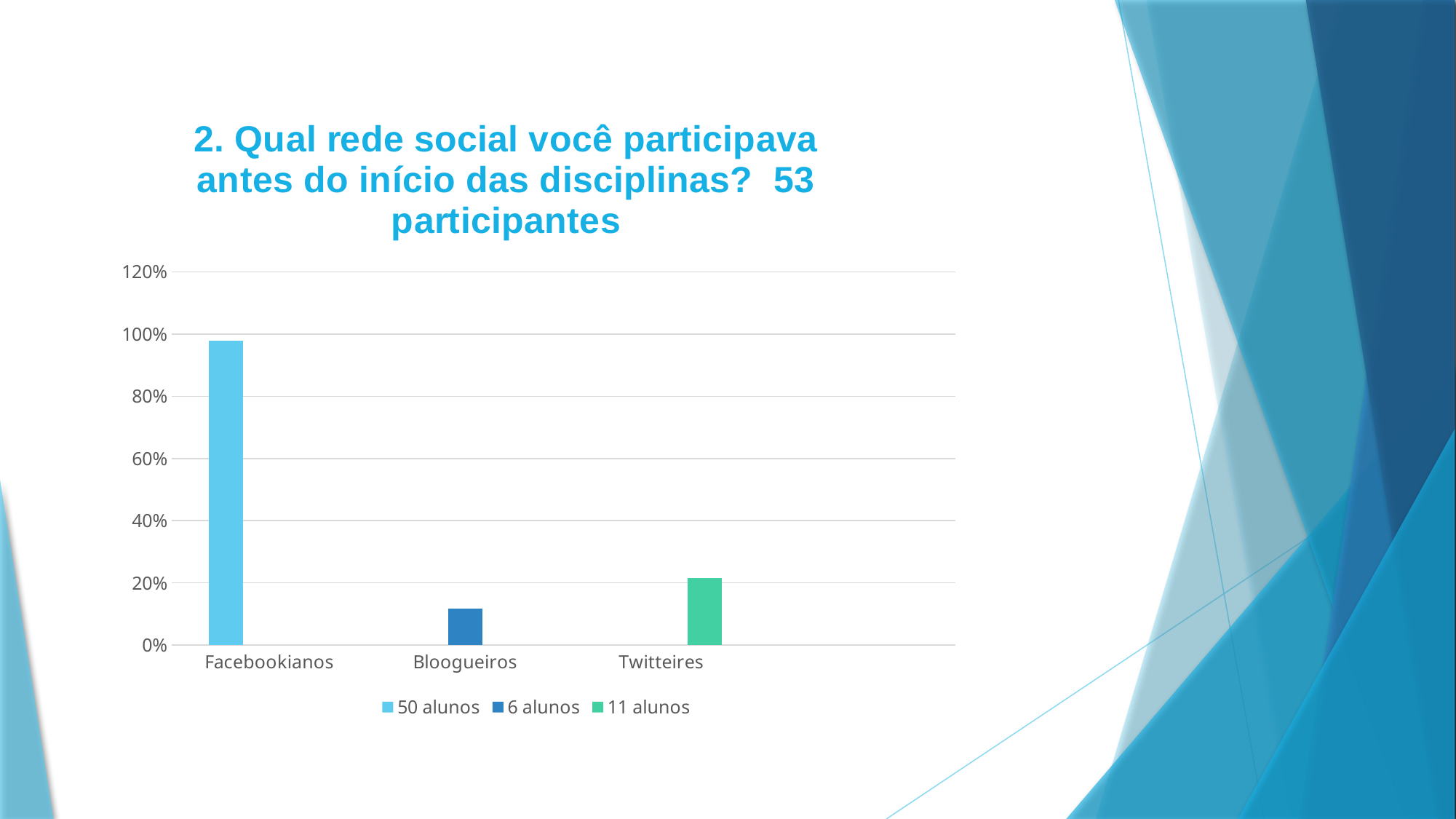
What kind of chart is shown on the slide? bar chart Which category has the highest bar in the chart? Facebookianos How many categories are shown on the x axis of the chart? 3 Which category has the lowest bar in the chart? Bloogueiros Is the value for Facebookianos greater or less than 80%? greater Which is larger, the value for Twitteires or the value for Bloogueiros? Twitteires Which legend entry corresponds to the green bar in the chart? 11 alunos Is the value for Bloogueiros greater or less than 20%? less How many participants does the chart title say took part in the survey? 53 participantes Is the value for Twitteires greater or less than 40%? less How many entries does the chart's legend list? 3